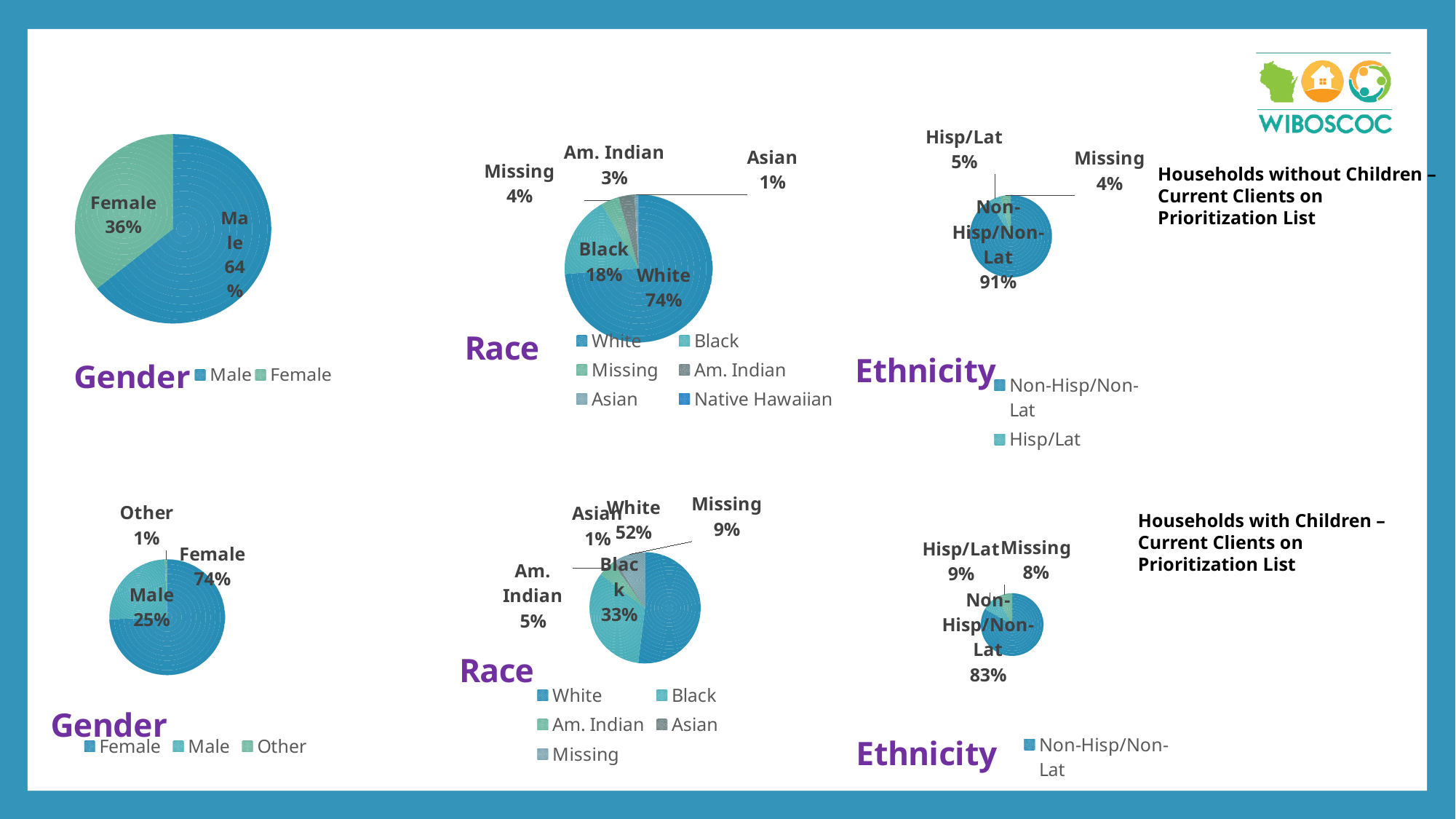
In the Race pie chart for Households without Children (top middle), what share is Black? 18% In the Ethnicity pie chart for Households without Children (top right), what share is Non-Hisp/Non-Lat? 91% In the Race pie chart for Households with Children (bottom middle), what is the difference between the White and Black shares? 19 percentage points In the Race pie chart for Households without Children (top middle), how many entries does the legend list? 6 In the Race pie chart for Households with Children (bottom middle), what share is Black? 33% In the Gender pie chart for Households without Children (top left), what share is Male? 64% In the Race pie chart for Households without Children (top middle), which category has the largest share? White In the Ethnicity pie chart for Households without Children (top right), which is larger, Hisp/Lat or Missing? Hisp/Lat In the Gender pie chart for Households with Children (bottom left), which category has the smallest share? Other In the Gender pie chart for Households without Children (top left), what is the difference between the Male and Female shares? 28 percentage points In the Gender pie chart for Households with Children (bottom left), what share is Female? 74% In the Ethnicity pie chart for Households with Children (bottom right), what share is Non-Hisp/Non-Lat? 83%